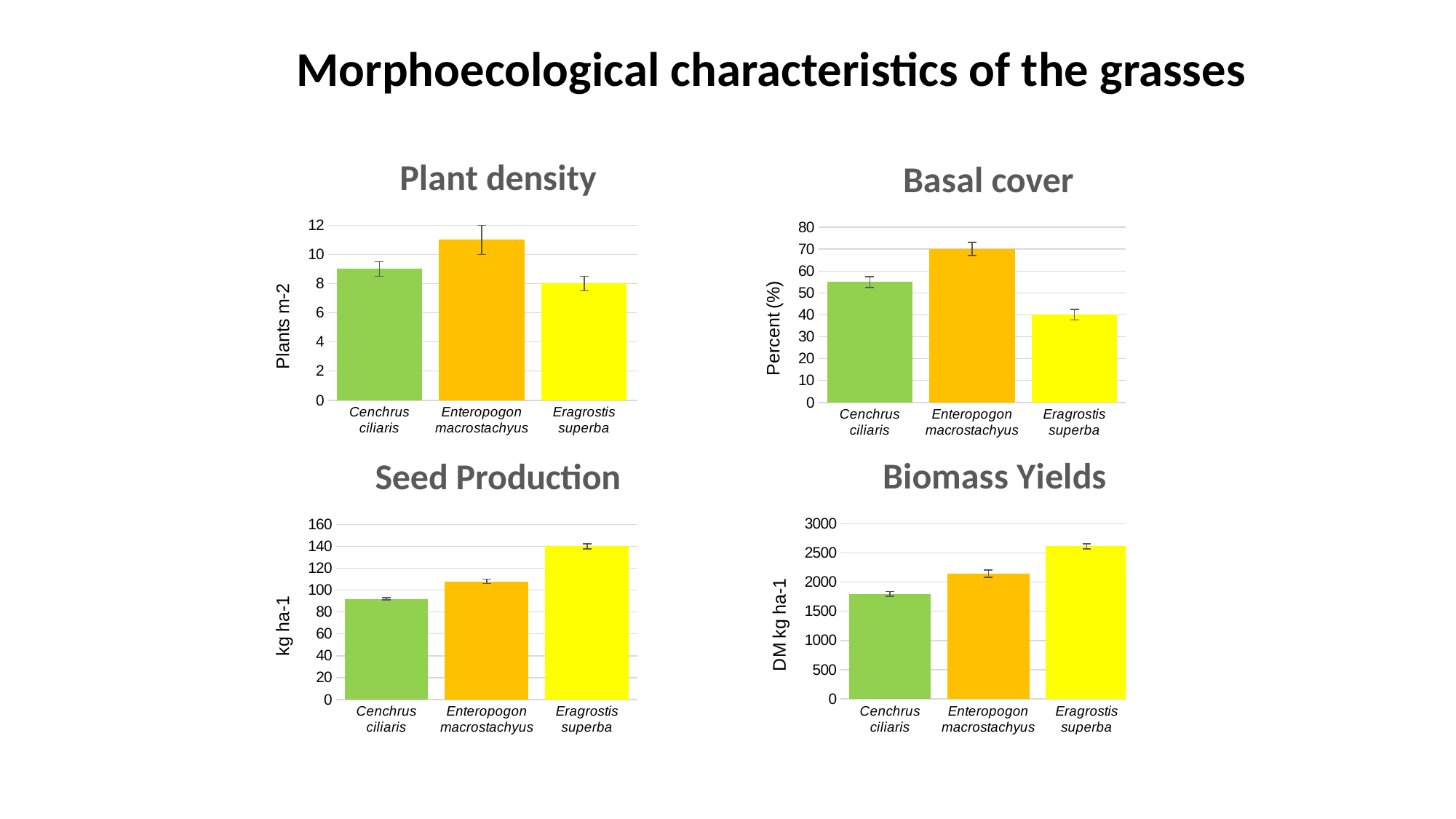
In the Basal cover chart, what is the difference between the values for Enteropogon macrostachyus and Eragrostis superba? 30 What kind of chart is the Biomass Yields chart? Bar chart In the Plant density chart, what is the value for Eragrostis superba? 8 In the Basal cover chart, what is the value for Enteropogon macrostachyus? 70 In the Biomass Yields chart, is the value for Enteropogon macrostachyus greater or less than 2000? greater In the Biomass Yields chart, which grass has the lowest value? Cenchrus ciliaris In the Seed Production chart, what is the value for Eragrostis superba? 140 In the Basal cover chart, which is larger, the value for Cenchrus ciliaris or the value for Eragrostis superba? Cenchrus ciliaris How many grass species are shown in the Seed Production chart? 3 In the Plant density chart, which grass has the highest value? Enteropogon macrostachyus In the Seed Production chart, is the value for Cenchrus ciliaris greater or less than 100? less In the Basal cover chart, what is the value for Eragrostis superba? 40